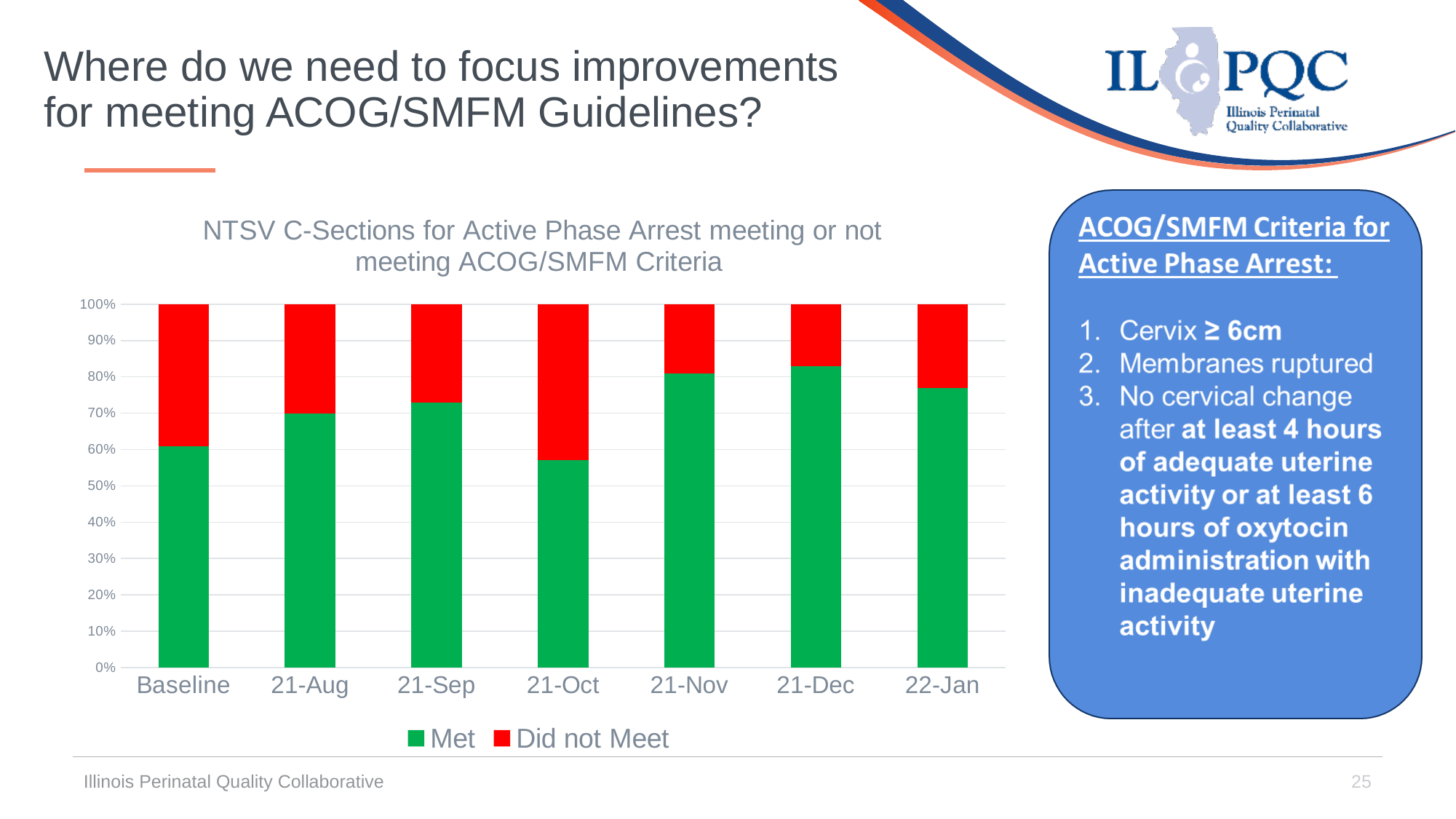
Which category has the lowest 'Met' share? 21-Oct Is the 'Met' value for Baseline greater or less than 70%? less Which colour represents the 'Did not Meet' series in the chart? Red Is the 'Met' value for 21-Oct greater or less than 60%? less Is the 'Met' value for 22-Jan greater or less than 70%? greater What are the two series named in the chart legend? Met and Did not Meet What kind of chart is shown on the slide? Stacked bar chart How many categories are shown on the x axis of the chart? 7 How many series does the chart legend list? 2 What is the total of the stacked bar for Baseline? 100% Which category has the highest 'Did not Meet' share? 21-Oct Which has a larger 'Met' share, 21-Oct or 21-Nov? 21-Nov